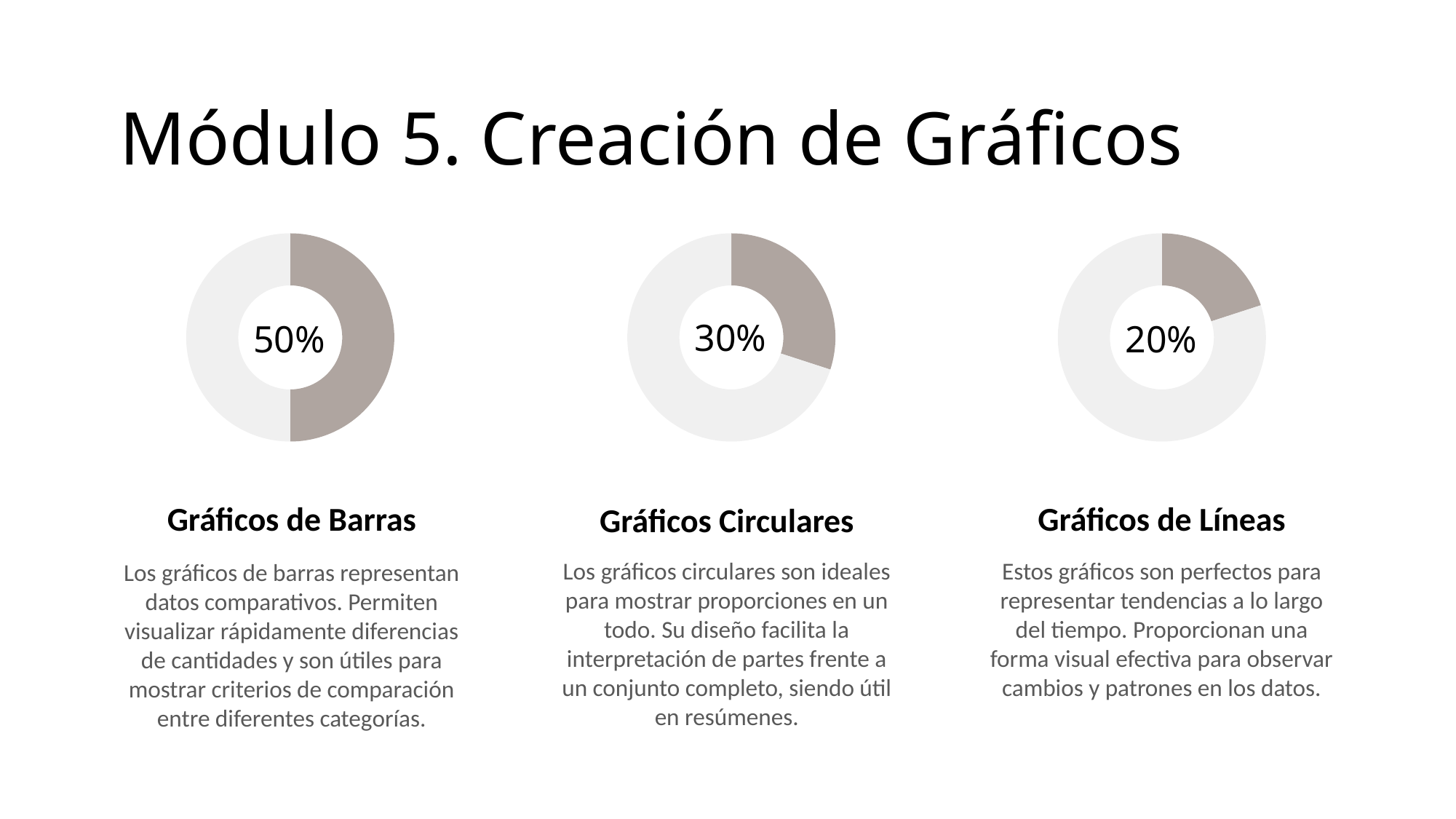
What kind of chart is used for each of the three percentages on the slide? Donut chart How many donut charts are on the slide? 3 What percentage is shown in the centre of the middle donut chart, above "Gráficos Circulares"? 30% What percentage is shown in the centre of the left donut chart, above "Gráficos de Barras"? 50% What is the difference between the percentage in the left donut chart and the percentage in the right donut chart? 30% Which of the three donut charts shows the lowest percentage? The right one (Gráficos de Líneas), 20% Which is larger: the percentage in the middle donut chart or the percentage in the right donut chart? The middle donut chart (30%) What is the title of the slide containing the three donut charts? Módulo 5. Creación de Gráficos What percentage is shown in the centre of the right donut chart, above "Gráficos de Líneas"? 20% Which of the three donut charts shows the highest percentage? The left one (Gráficos de Barras), 50% What is the total of the three percentages shown in the donut charts? 100% What is the difference between the percentage in the middle donut chart and the percentage in the right donut chart? 10%